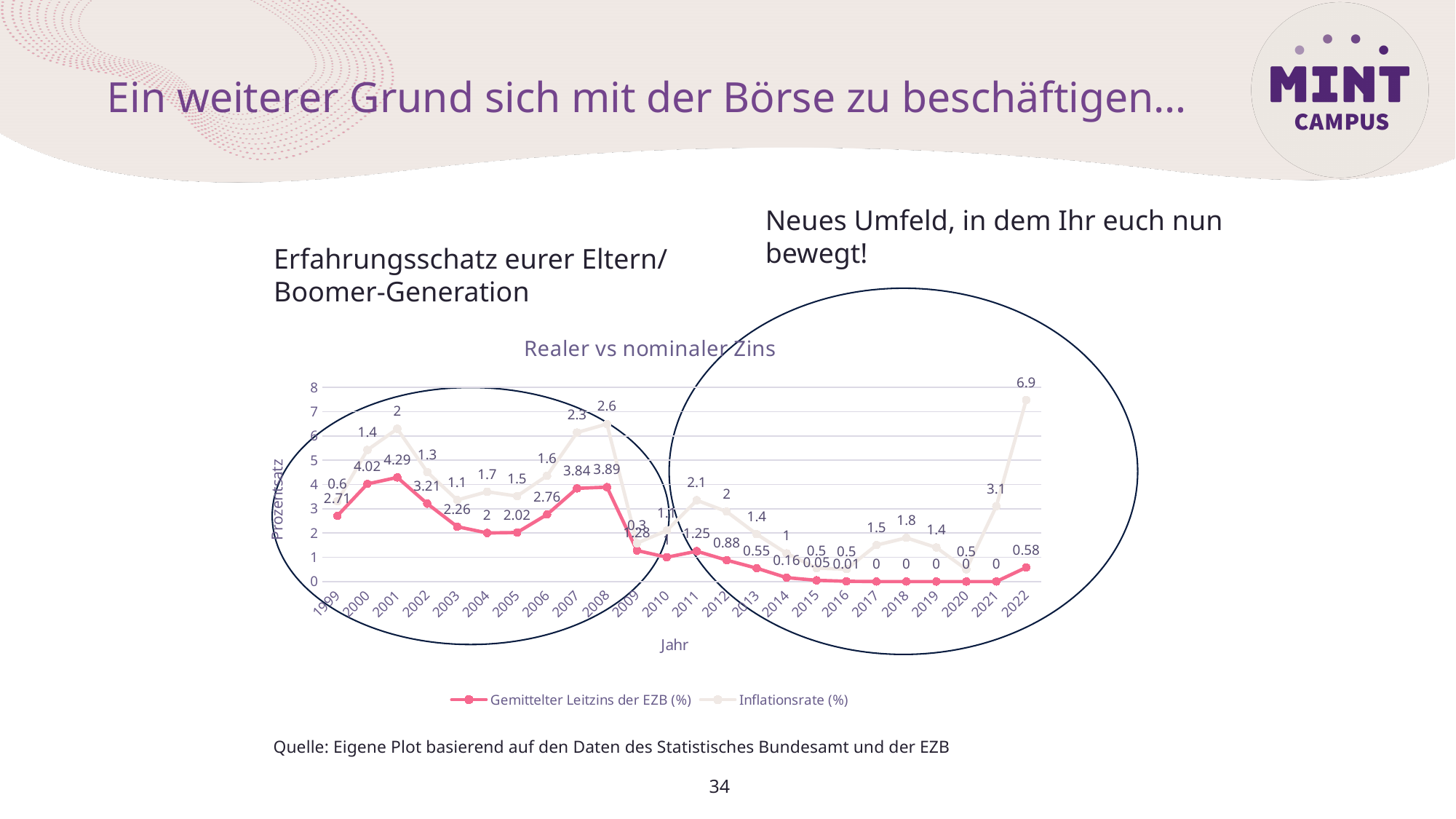
How many series does the legend of the chart list? 2 What is the value of 'Gemittelter Leitzins der EZB (%)' in 2001? 4.29 What is the difference between the 'Gemittelter Leitzins der EZB (%)' values for 2008 and 2009? 2.61 How many years are plotted on the x axis of the chart? 24 Which year has the larger 'Gemittelter Leitzins der EZB (%)' value, 2000 or 2007? 2000 Does the 'Gemittelter Leitzins der EZB (%)' rise or fall from 2011 to 2016? fall In which year is the 'Inflationsrate (%)' highest? 2022 What is the difference between the 'Inflationsrate (%)' values for 2022 and 2021? 3.8 What type of chart is shown on the slide? line chart What is the value of 'Gemittelter Leitzins der EZB (%)' in 2022? 0.58 In which year is the 'Gemittelter Leitzins der EZB (%)' highest? 2001 What is the value of 'Inflationsrate (%)' in 2022? 6.9